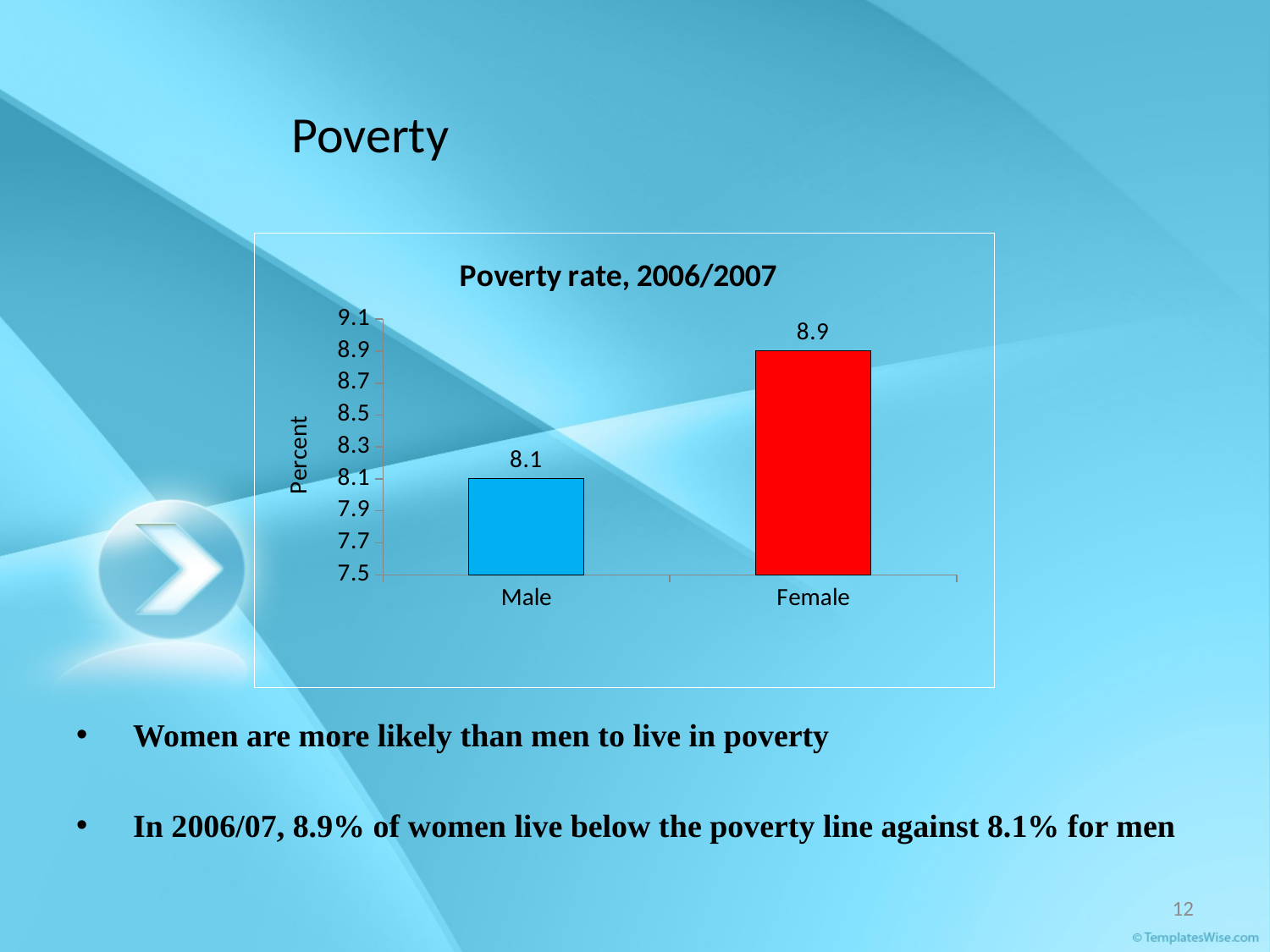
Which category has the lower poverty rate? Male What is the poverty rate for Male? 8.1 What is the difference between the Female and Male poverty rates? 0.8 Is the Male bar larger or smaller than the Female bar? smaller Is the poverty rate for Female greater or less than 8.5? greater What is the poverty rate for Female? 8.9 What is the title of the chart? Poverty rate, 2006/2007 What kind of chart is shown? bar chart How many categories are shown on the x axis? 2 Which category has the higher poverty rate? Female What is the label of the vertical axis? Percent Is the poverty rate for Male greater or less than 8.5? less